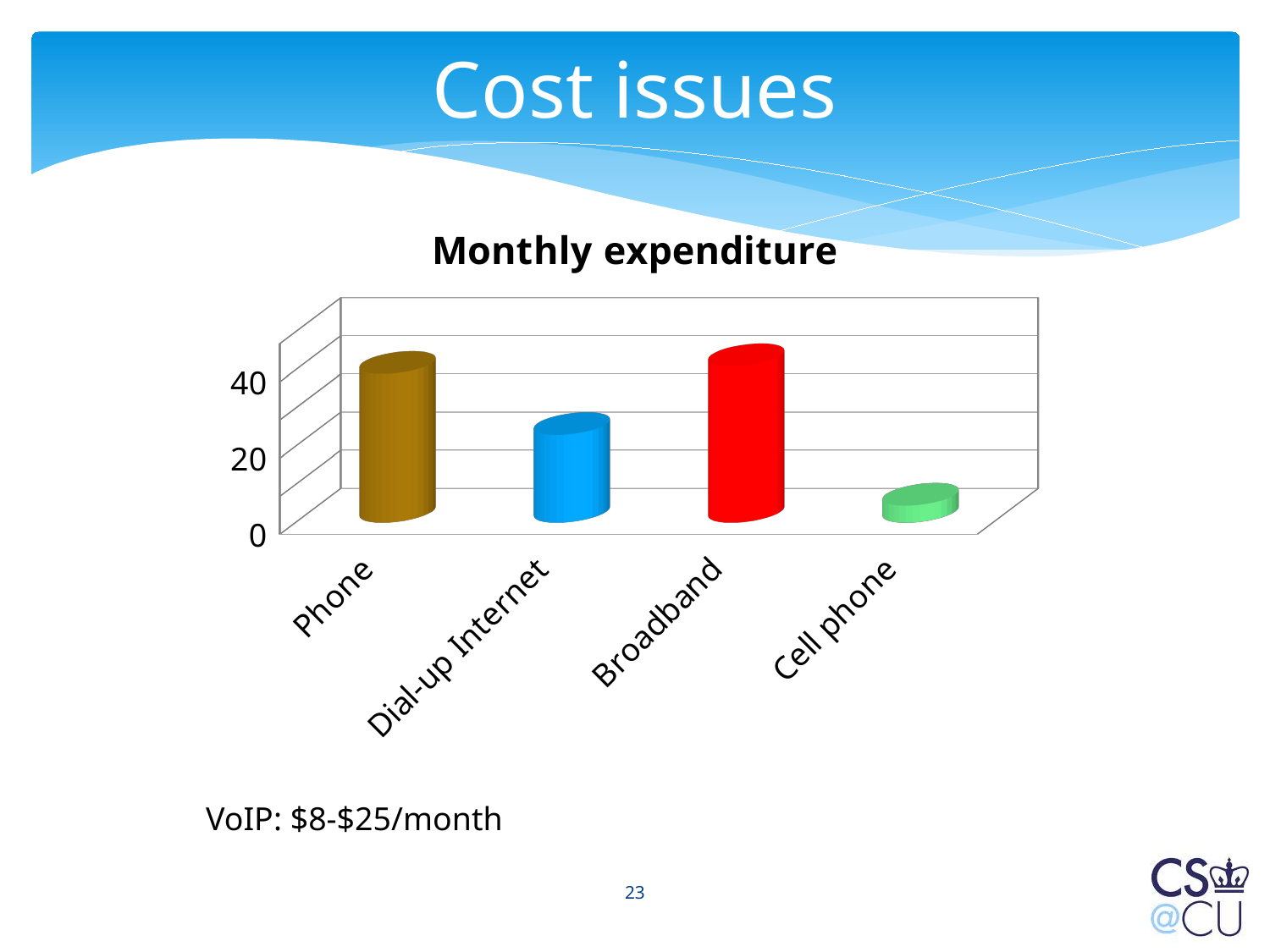
Is the value for Phone greater or less than 20? greater Which is larger, the value for Broadband or the value for Cell phone? Broadband How many categories are shown on the x axis of the chart? 4 What is the title of the chart? Monthly expenditure What kind of chart is shown on the slide? bar chart Is the value for Cell phone greater or less than 20? less Is the value for Broadband greater or less than 20? greater Which category has the highest monthly expenditure? Broadband Which category has the lowest monthly expenditure? Cell phone What colour is the Broadband bar? red Which is larger, the value for Phone or the value for Dial-up Internet? Phone